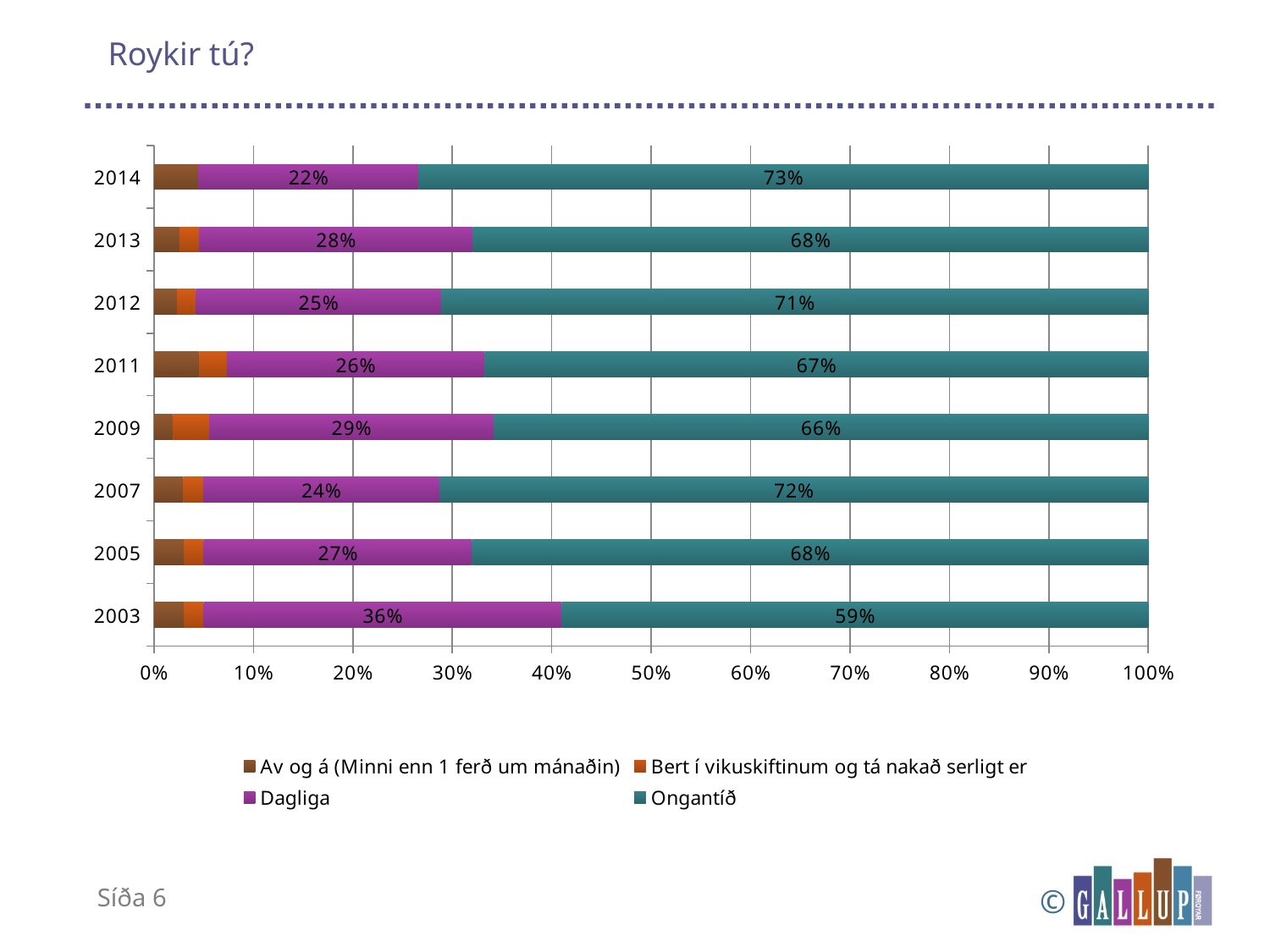
Is the value for Ongantíð in 2011 greater or less than 60%? greater What is the difference between the Dagliga values for 2003 and 2014? 14% Which year has the lowest value for Ongantíð? 2003 Which year has the highest value for Dagliga? 2003 What is the value for Dagliga in 2014? 22% What kind of chart is shown on the slide? Stacked bar chart What is the value for Ongantíð in 2003? 59% How many years are shown on the chart? 8 What is the value for Dagliga in 2009? 29% What is the title of the slide? Roykir tú? How many series does the legend list? 4 Which is larger, the Ongantíð value for 2013 or for 2014? 2014